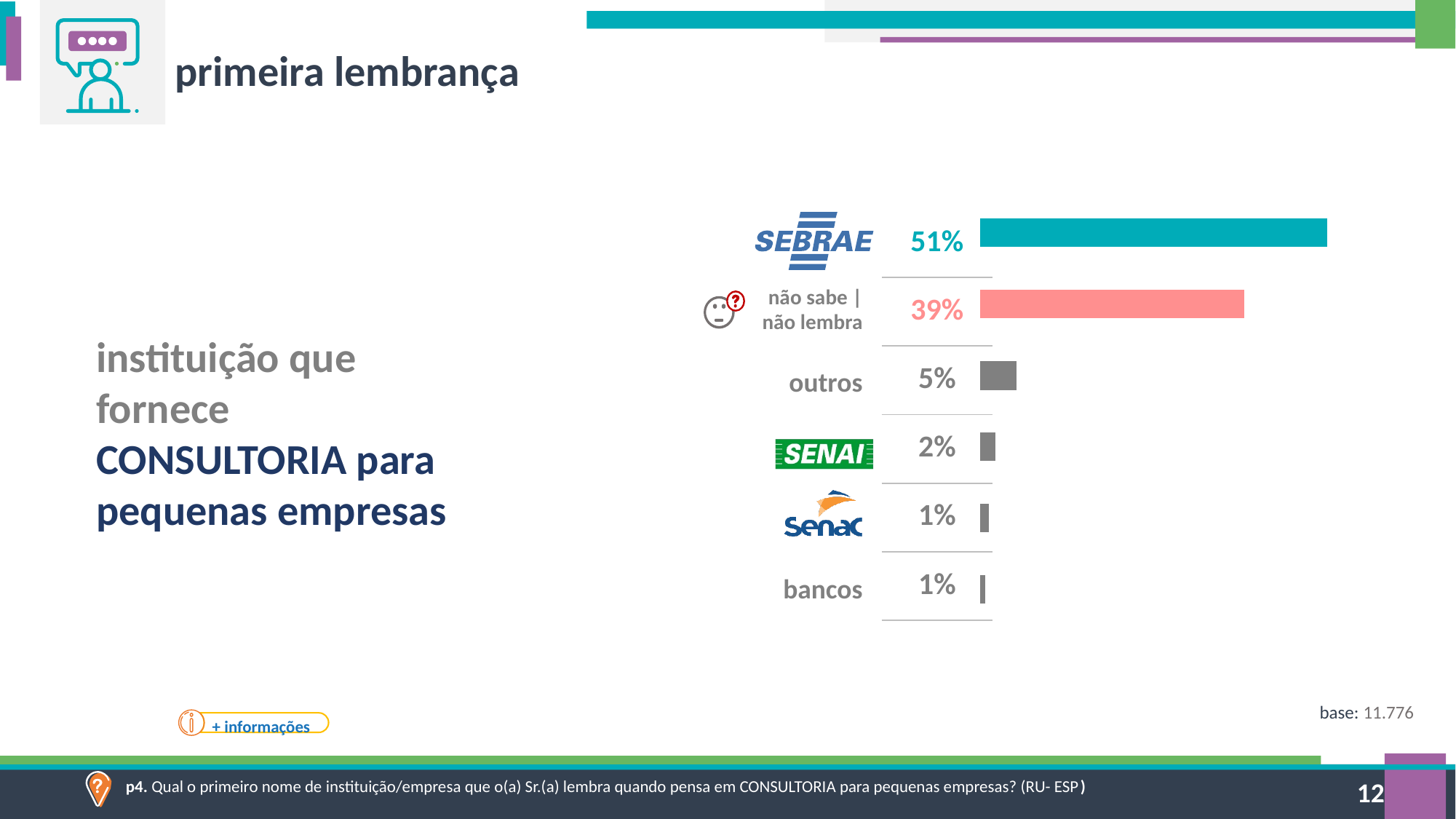
What percentage is shown for 'outros'? 5% What percentage is shown for 'bancos'? 1% Which category has the highest percentage? SEBRAE How many categories are shown in the chart? 6 What percentage is shown for SENAI? 2% What is the title of the slide? primeira lembrança What percentage is shown for 'não sabe | não lembra'? 39% Which is larger, the value for 'outros' or the value for SENAI? outros What kind of chart is shown on the slide? bar chart What is the base (number of respondents) shown on the slide? 11.776 What percentage is shown for SEBRAE? 51% What is the difference in percentage points between SEBRAE and 'não sabe | não lembra'? 12